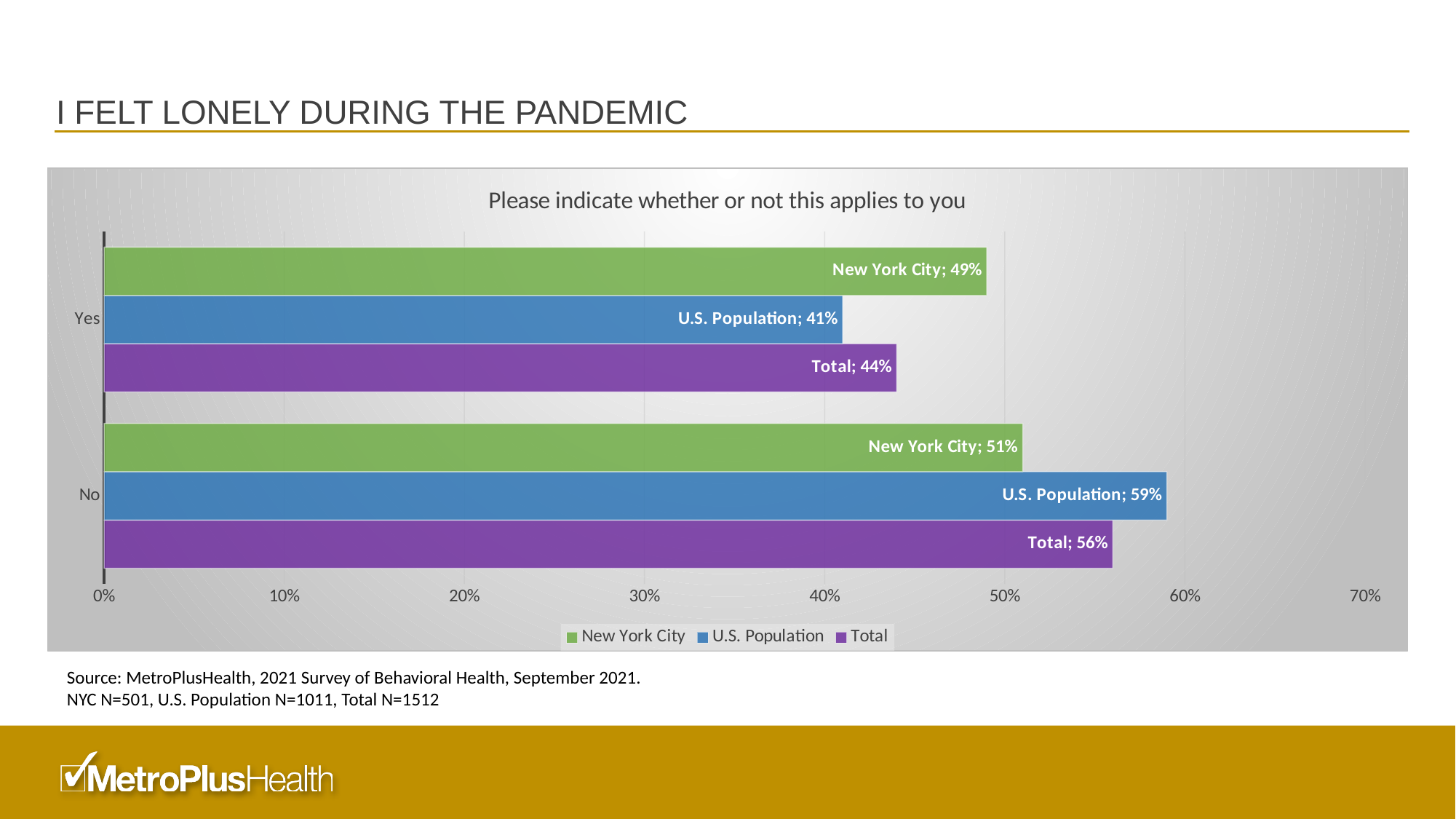
What kind of chart is shown on the slide? Bar chart What is the Total value for the Yes category? 44% Which series has the lowest value in the Yes category? U.S. Population What is the difference between the New York City and U.S. Population values for Yes? 8% What is the title of the chart? Please indicate whether or not this applies to you Which series has the highest value in the No category? U.S. Population How many categories are shown on the vertical axis? 2 How many series does the legend list? 3 What is the U.S. Population value for the No category? 59% Which is larger for the Total series: Yes or No? No Is the New York City value for No greater or less than 50%? greater What percentage of New York City respondents answered Yes? 49%